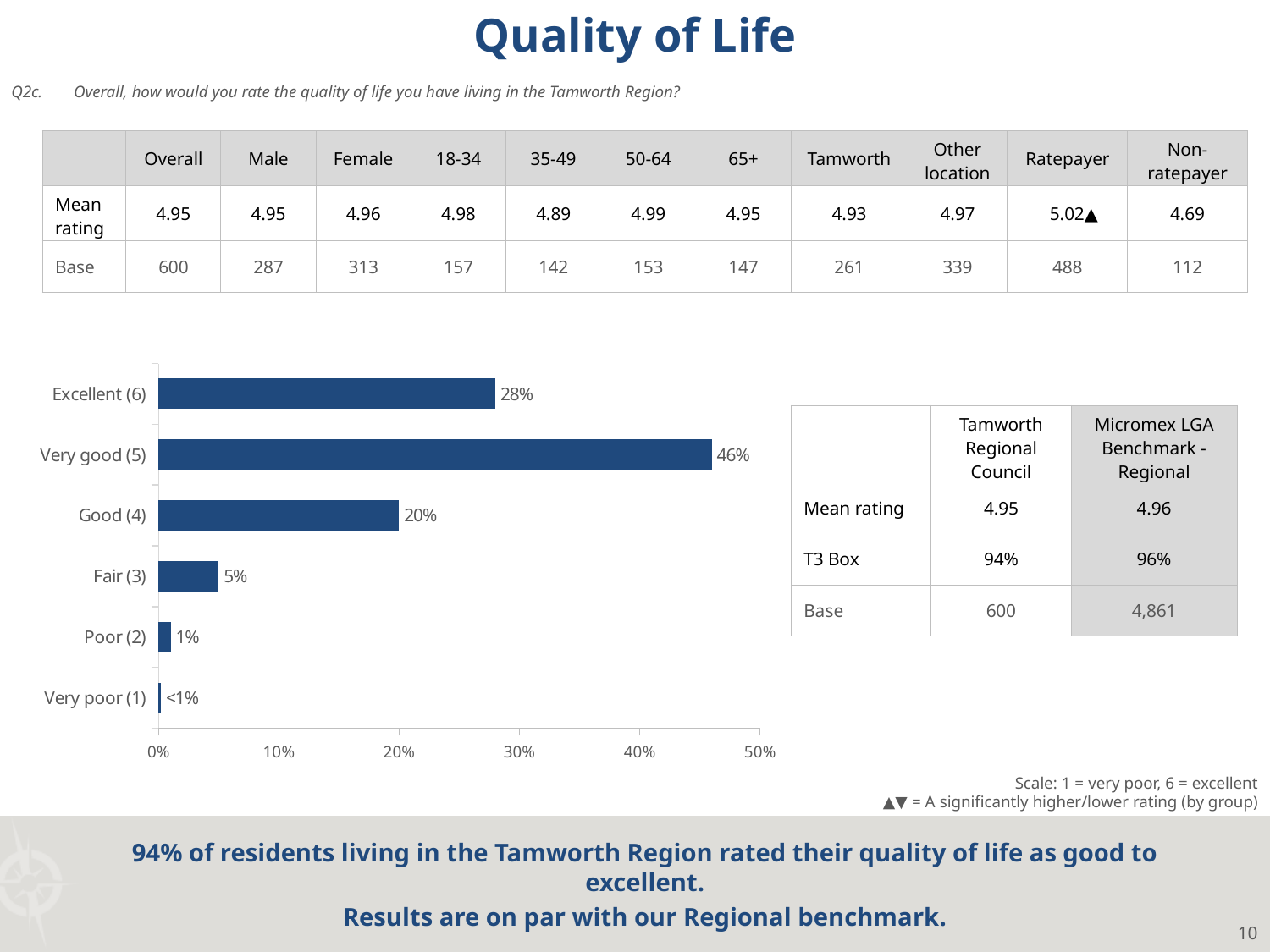
What is the combined percentage for Excellent (6), Very good (5) and Good (4)? 94% What is the value shown for Fair (3) in the bar chart? 5% What percentage of respondents rated their quality of life as Excellent (6)? 28% What is the difference in percentage points between Very good (5) and Excellent (6)? 18% Which rating category has the lowest percentage in the bar chart? Very poor (1) What percentage of respondents rated their quality of life as Very good (5)? 46% What is the value shown for Very poor (1) in the bar chart? <1% Which is larger, the percentage for Good (4) or the percentage for Fair (3)? Good (4) Which rating category has the highest percentage in the bar chart? Very good (5) How many rating categories are shown in the bar chart? 6 What is the difference in percentage points between Excellent (6) and Good (4)? 8% What type of chart is used to show the quality of life ratings? Bar chart